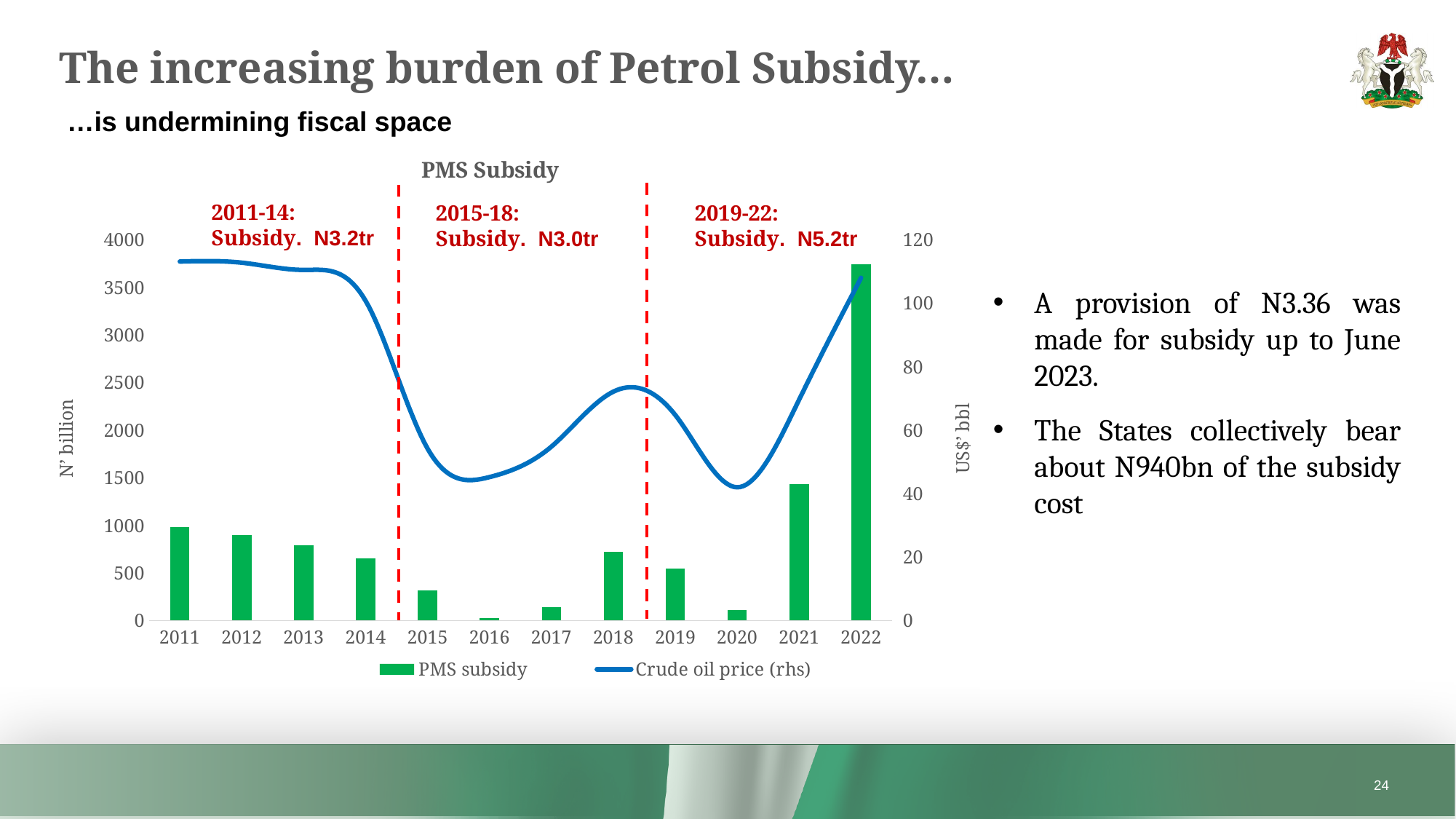
Is the PMS subsidy value for 2022 greater or less than 3500? greater Do the PMS subsidy bars rise or fall from 2011 to 2014? fall How many series does the legend of the PMS Subsidy chart list? 2 What is the title of the chart? PMS Subsidy Which year has the larger PMS subsidy bar, 2012 or 2014? 2012 Which year has the highest PMS subsidy bar? 2022 What kind of chart is shown on the slide? A combined bar and line chart Which year has the lowest PMS subsidy bar? 2016 Is the crude oil price for 2016 greater or less than 60? less How many years are shown on the x axis of the PMS Subsidy chart? 12 Is the PMS subsidy value for 2020 greater or less than 500? less According to the annotation on the chart, what was the total subsidy for 2019-22? N5.2tr